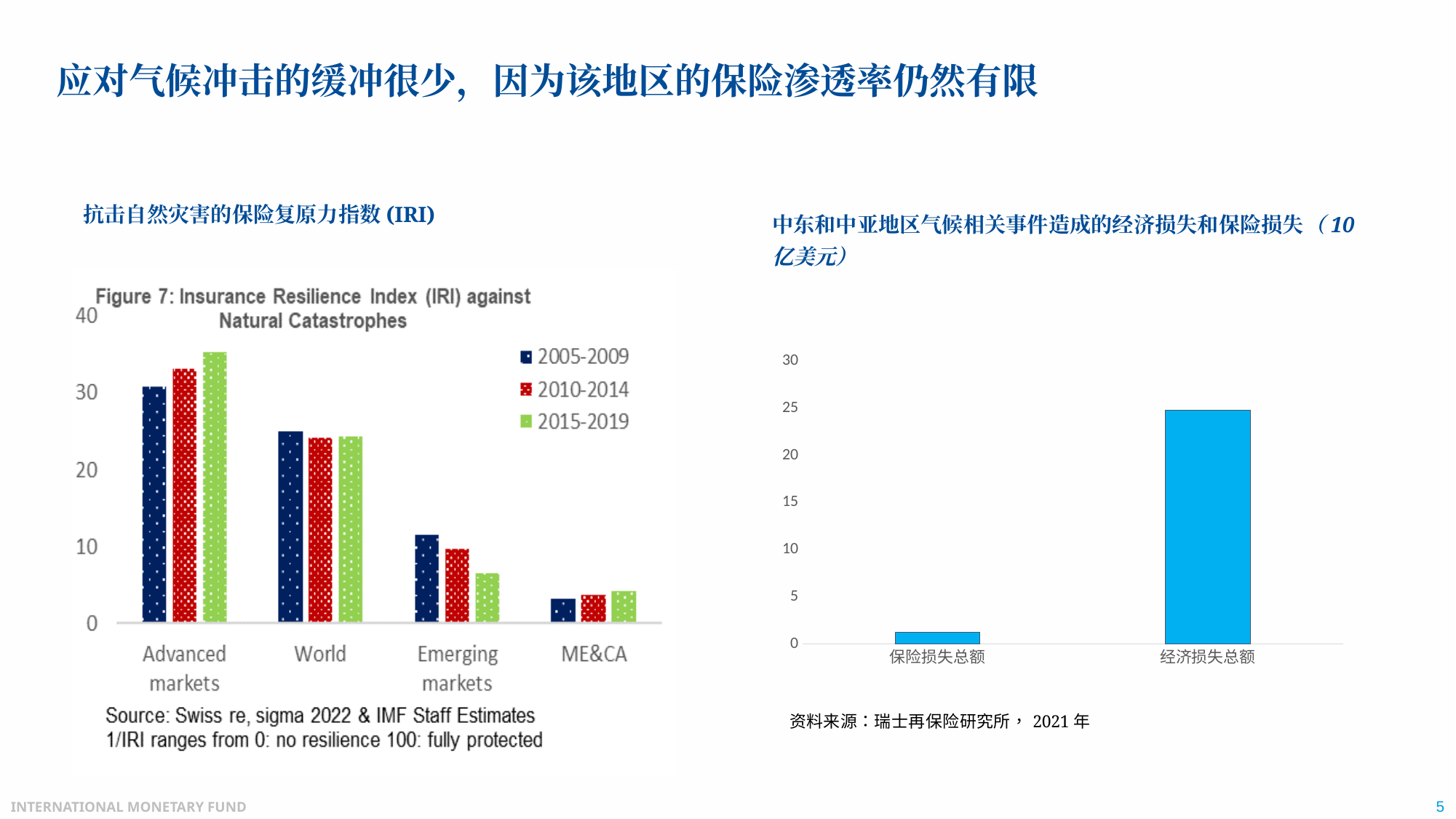
What kind of chart is the Insurance Resilience Index (IRI) chart on the left? bar chart In the left chart (Insurance Resilience Index), which category has the highest values? Advanced markets In the left chart (Insurance Resilience Index), do the values for Emerging markets rise or fall from 2005-2009 to 2015-2019? fall In the left chart (Insurance Resilience Index), is the 2015-2019 value for ME&CA greater or less than 10? less In the left chart (Insurance Resilience Index), is the 2015-2019 value for Advanced markets greater or less than 30? greater In the right chart (经济损失和保险损失), which category has the higher bar? 经济损失总额 In the right chart (经济损失和保险损失), is the value for 经济损失总额 greater or less than 20? greater In the left chart (Insurance Resilience Index), for Emerging markets, which is larger: the 2005-2009 value or the 2015-2019 value? 2005-2009 What is the source cited below the left chart (Insurance Resilience Index)? Swiss re, sigma 2022 & IMF Staff Estimates In the left chart (Insurance Resilience Index), which category has the lowest values? ME&CA How many categories are shown on the x axis of the left chart (Insurance Resilience Index)? 4 How many series does the legend of the left chart (Insurance Resilience Index) list? 3